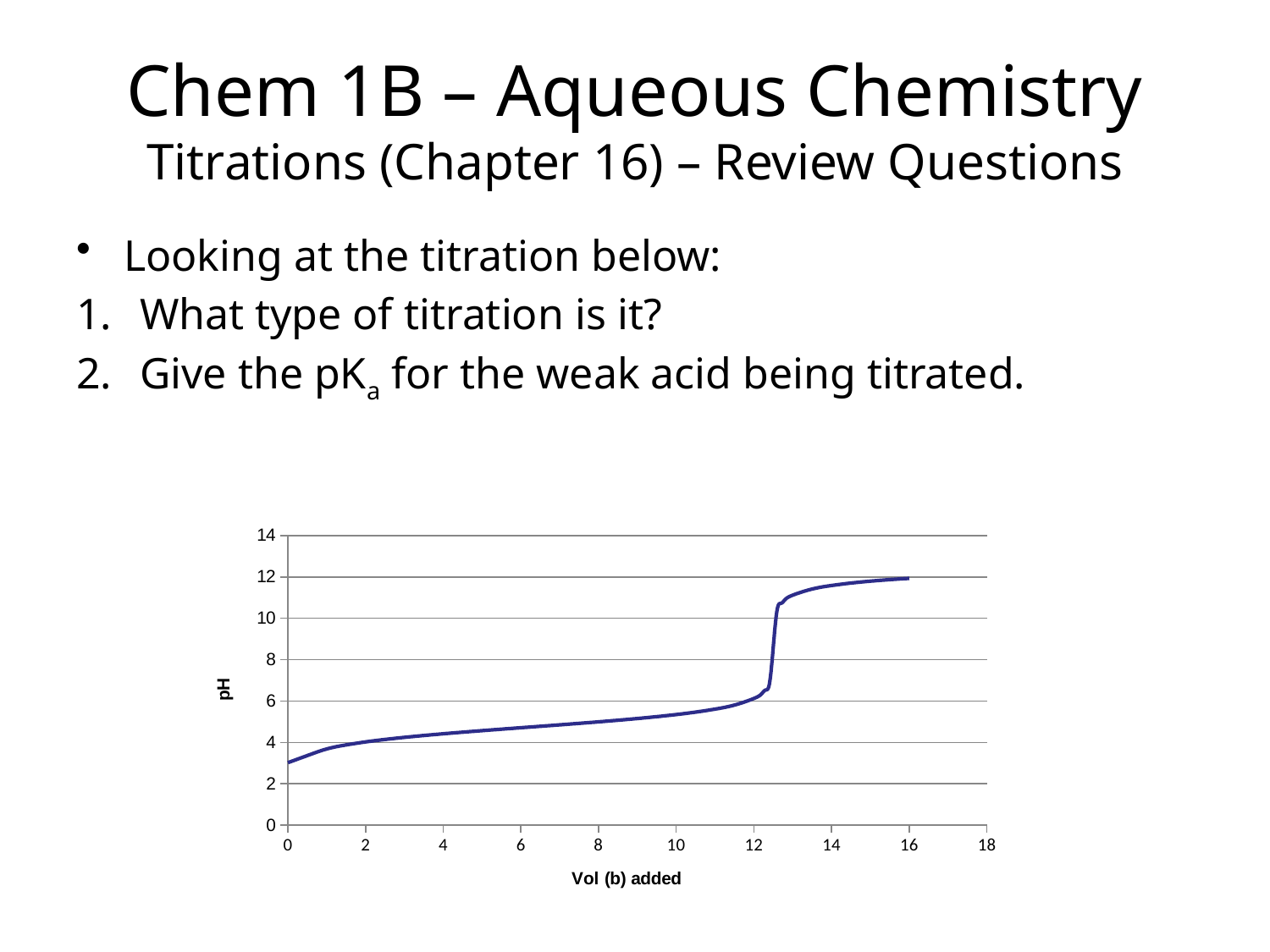
Is the pH at a volume of 4 greater or less than 6? less Is the pH at a volume of 14 greater or less than 10? greater What is the label of the y axis of the chart? pH What is the label of the x axis of the chart? Vol (b) added What kind of chart is shown on the slide? line chart Is the pH at a volume of 8 greater or less than 6? less Does the pH rise or fall as the volume of base added increases along the x axis? rise Is the pH higher at a volume of 14 or at a volume of 4? 14